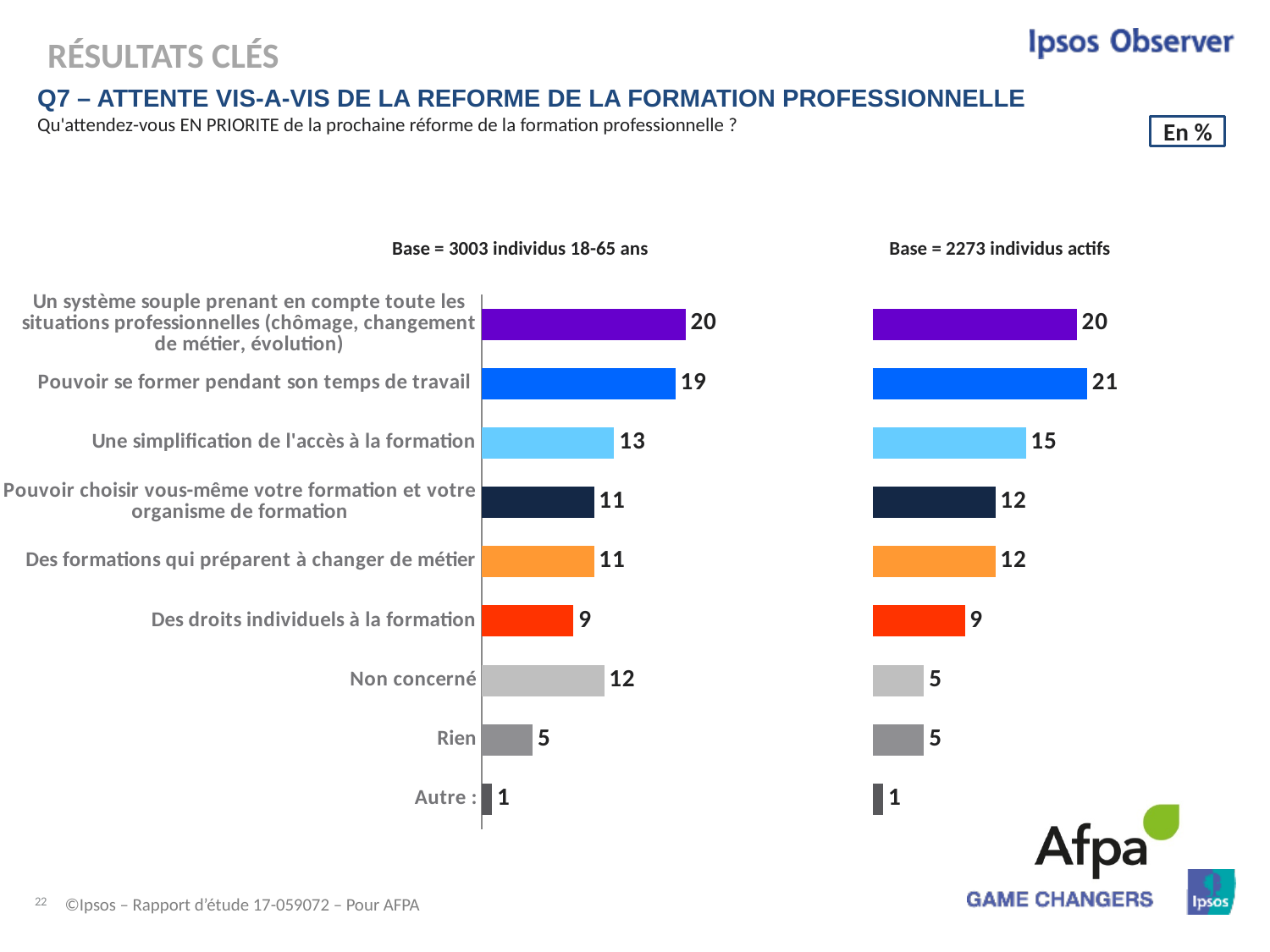
In the chart 'Base = 3003 individus 18-65 ans', what is the value for 'Pouvoir se former pendant son temps de travail'? 19 What unit are the values on the slide expressed in, according to the box at the top right? En % In the chart 'Base = 3003 individus 18-65 ans', which is larger: 'Une simplification de l'accès à la formation' or 'Des droits individuels à la formation'? Une simplification de l'accès à la formation In the chart 'Base = 2273 individus actifs', what is the value for 'Une simplification de l'accès à la formation'? 15 How many categories are shown in the chart 'Base = 3003 individus 18-65 ans'? 9 In the chart 'Base = 3003 individus 18-65 ans', which category has the lowest value? Autre : What type of chart is used for 'Base = 2273 individus actifs'? Bar chart In the chart 'Base = 3003 individus 18-65 ans', what is the value for 'Non concerné'? 12 In the chart 'Base = 2273 individus actifs', which category has the highest value? Pouvoir se former pendant son temps de travail In the chart 'Base = 2273 individus actifs', what is the difference between 'Pouvoir se former pendant son temps de travail' and 'Des droits individuels à la formation'? 12 In the chart 'Base = 3003 individus 18-65 ans', what is the difference between 'Non concerné' and 'Rien'? 7 Which is larger: 'Non concerné' in the chart 'Base = 3003 individus 18-65 ans' or 'Non concerné' in the chart 'Base = 2273 individus actifs'? Base = 3003 individus 18-65 ans